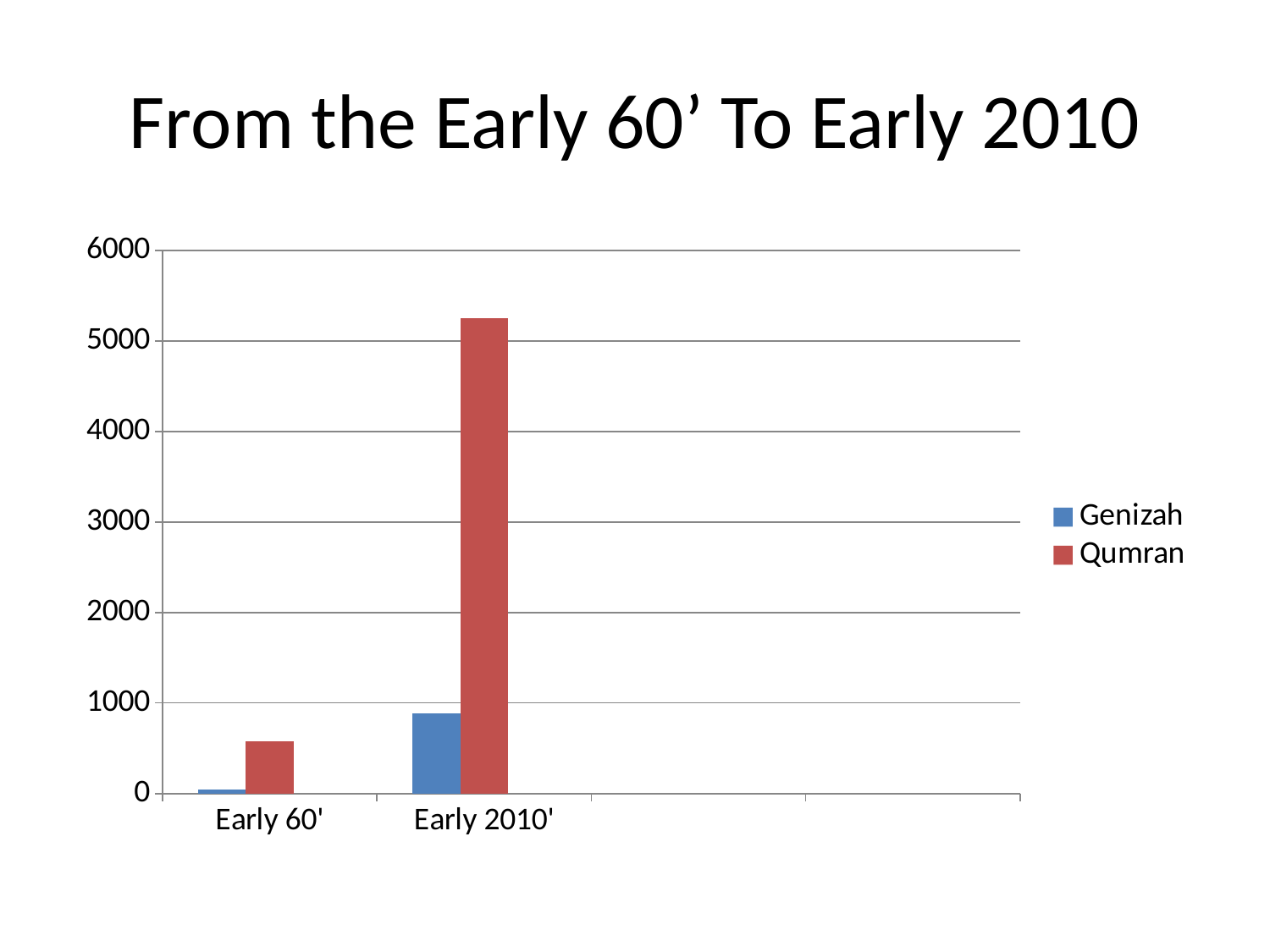
What is the title of the slide? From the Early 60' To Early 2010 Which series has the highest bar on the chart? Qumran Is the Qumran value for Early 2010' greater or less than 5000? greater Which category has the tallest Qumran bar? Early 2010' Which bar is the lowest on the chart? Genizah, Early 60' How many series does the legend list? 2 For Early 2010', which series has the larger value, Genizah or Qumran? Qumran Is the Genizah value for Early 2010' greater or less than 1000? less What kind of chart is shown on the slide? bar chart Do the Qumran values rise or fall from Early 60' to Early 2010'? rise How many categories are shown on the x axis? 2 Is the Qumran value for Early 60' greater or less than 1000? less